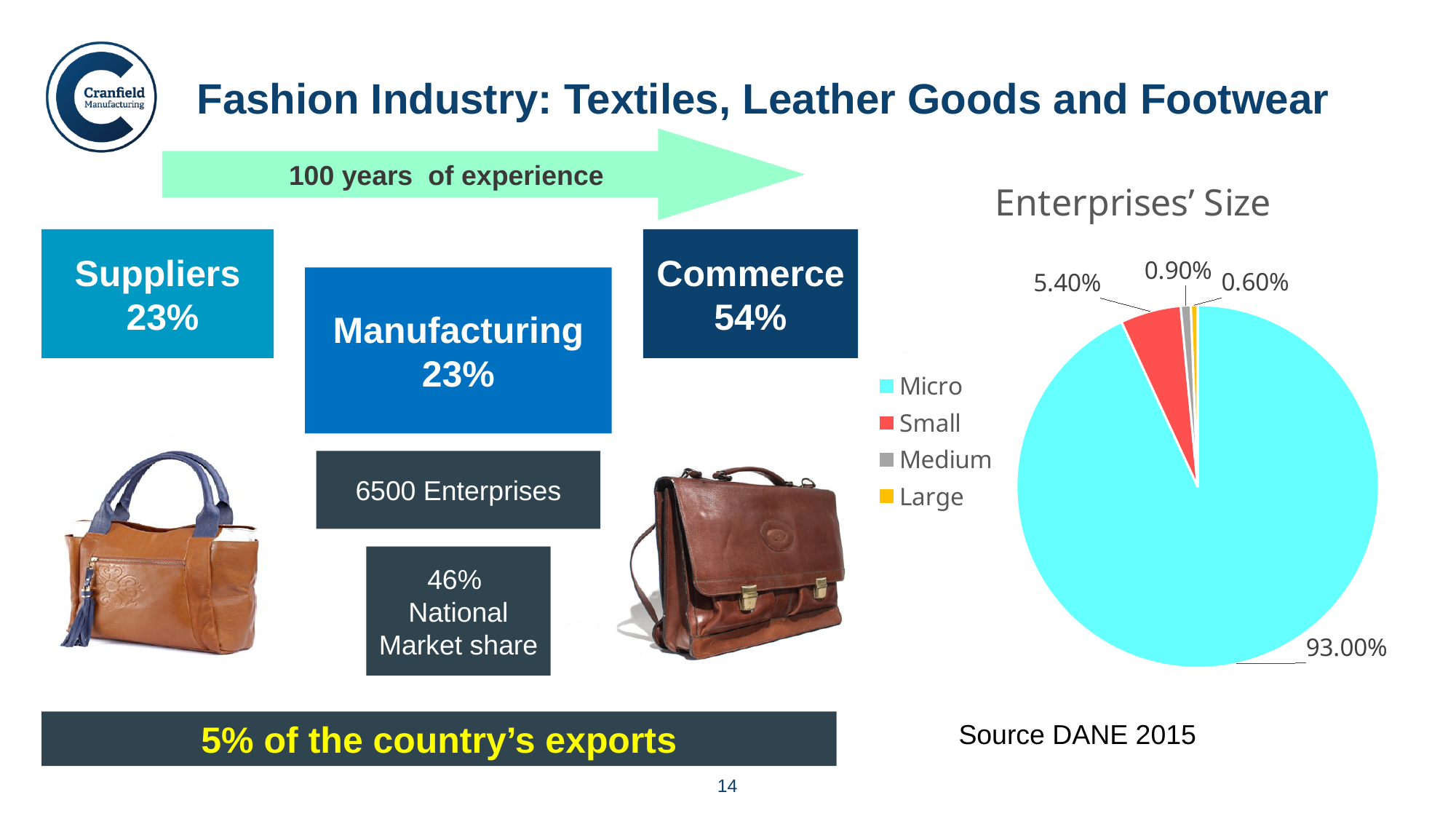
What colour represents Large enterprises in the pie chart? yellow What share of the pie chart is Medium enterprises? 0.90% What is the title of the pie chart? Enterprises' Size What share of the pie chart is Large enterprises? 0.60% What share of the pie chart is Micro enterprises? 93.00% In the pie chart, which is larger: the Small slice or the Medium slice? Small What kind of chart is shown under the title "Enterprises' Size"? pie chart How many categories does the pie chart's legend list? 4 Which enterprise size has the largest slice of the pie chart? Micro What share of the pie chart is Small enterprises? 5.40% Which enterprise size has the smallest slice of the pie chart? Large What is the difference in percentage points between the Micro and Small slices of the pie chart? 87.60%